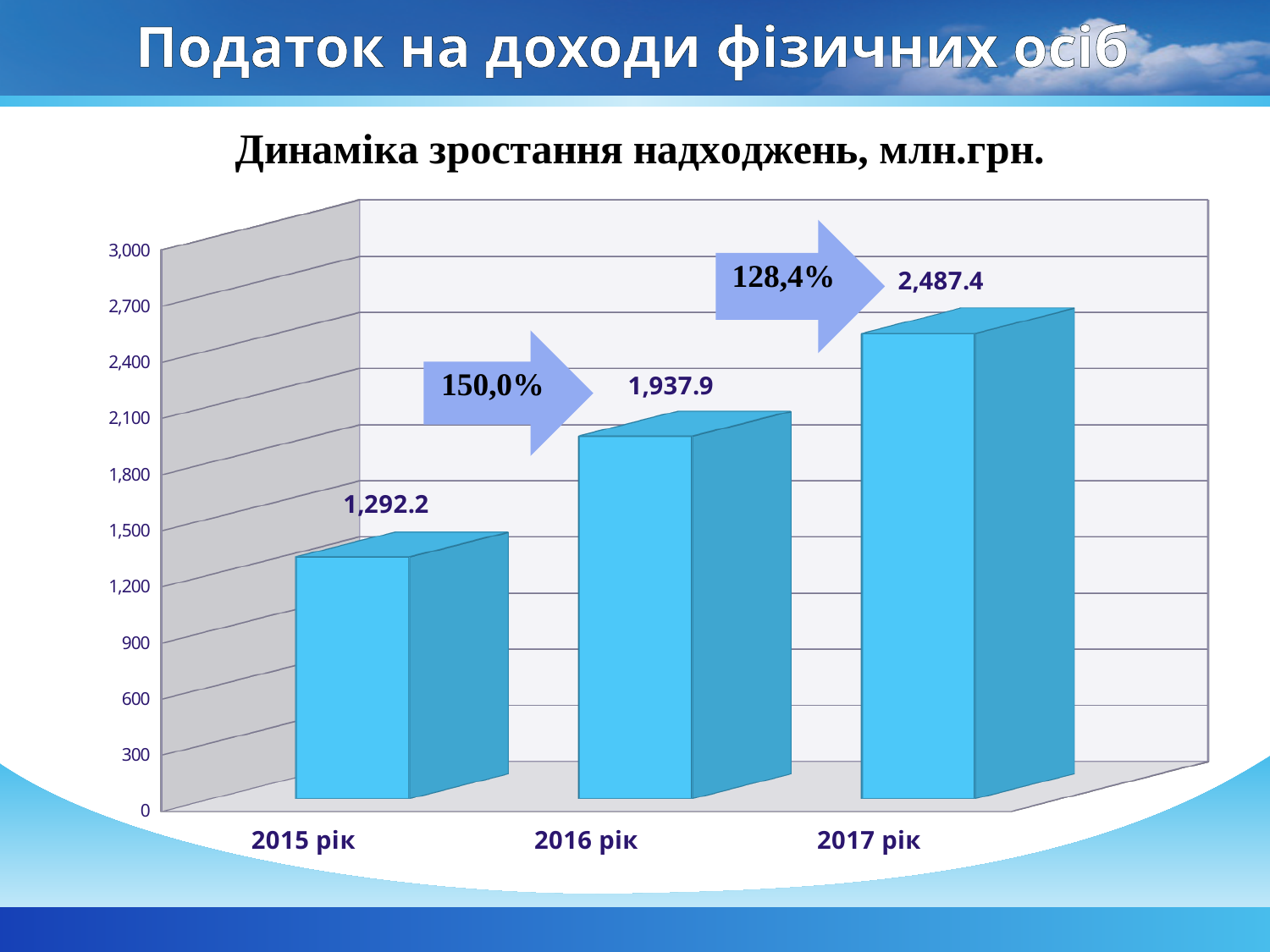
Do the values rise or fall from 2015 рік to 2017 рік? rise What is the value for 2017 рік? 2,487.4 Is the value for 2017 рік greater or less than 2,400? greater Which year has the lowest value? 2015 рік Which is larger, the value for 2016 рік or the value for 2015 рік? 2016 рік What is the difference between the values for 2017 рік and 2016 рік? 549.5 What is the value for 2016 рік? 1,937.9 Which year has the highest value? 2017 рік What kind of chart is shown on the slide? bar chart What is the difference between the values for 2016 рік and 2015 рік? 645.7 What is the value for 2015 рік? 1,292.2 How many years are shown on the chart? 3